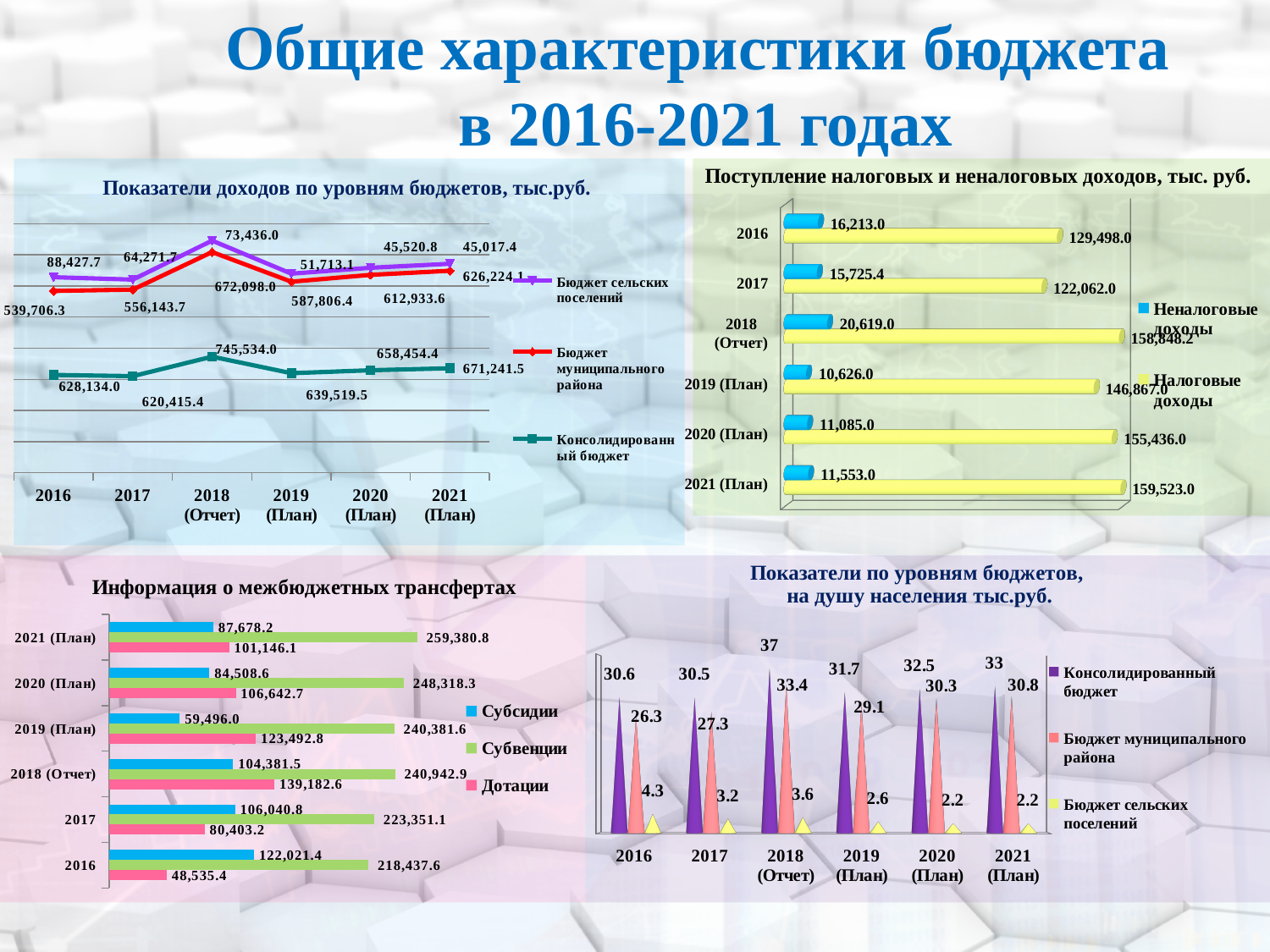
In the chart 'Информация о межбюджетных трансфертах', how many year categories are shown? 6 What kind of chart is 'Информация о межбюджетных трансфертах'? Bar chart In the chart 'Информация о межбюджетных трансфертах', what is the value of Дотации for 2016? 48,535.4 In the chart 'Информация о межбюджетных трансфертах', which is larger for 2019 (План): Субсидии or Дотации? Дотации In the chart 'Показатели по уровням бюджетов, на душу населения тыс.руб.', what is the value for Консолидированный бюджет in 2018 (Отчет)? 37 In the chart 'Показатели доходов по уровням бюджетов, тыс.руб.', what is the value for Консолидированный бюджет in 2018 (Отчет)? 745,534.0 In the chart 'Показатели доходов по уровням бюджетов, тыс.руб.', how many series does the legend list? 3 In the chart 'Показатели по уровням бюджетов, на душу населения тыс.руб.', does the Бюджет сельских поселений value rise or fall from 2016 to 2021? Fall In the chart 'Показатели доходов по уровням бюджетов, тыс.руб.', in which year is the Бюджет сельских поселений value highest? 2016 In the chart 'Поступление налоговых и неналоговых доходов, тыс. руб.', what is the value of Налоговые доходы for 2021 (План)? 159,523.0 In the chart 'Поступление налоговых и неналоговых доходов, тыс. руб.', what is the difference between Налоговые доходы in 2018 (Отчет) and 2017? 36,786.2 In the chart 'Поступление налоговых и неналоговых доходов, тыс. руб.', in which year is the Неналоговые доходы value lowest? 2019 (План)